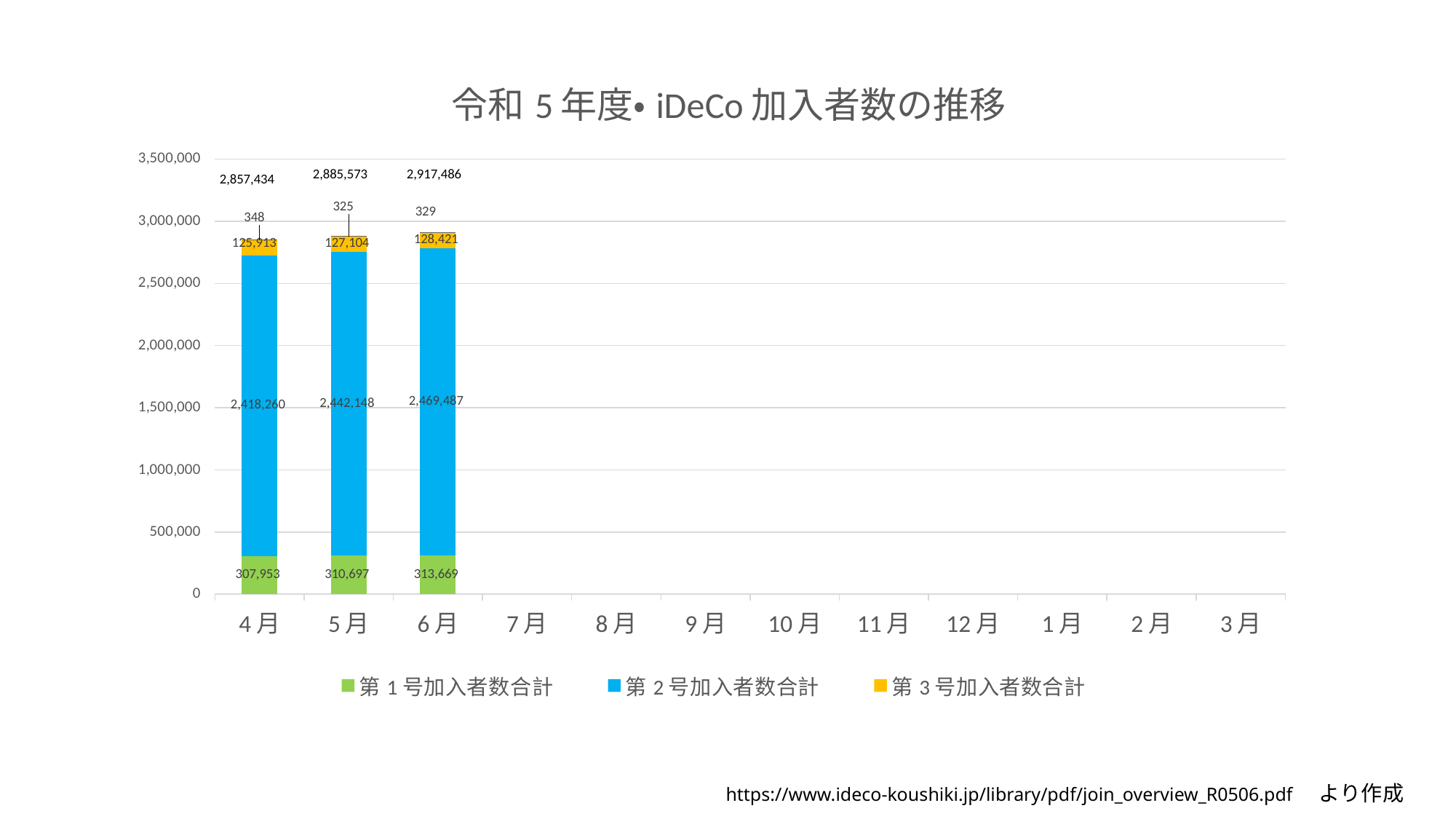
How many series does the legend list? 3 Among the months with data, which month has the lowest value for 第１号加入者数合計? 4月 How many month categories are shown on the x axis? 12 What is the value of 第２号加入者数合計 for 4月? 2,418,260 What is the value of 第３号加入者数合計 for 5月? 127,104 What is the difference between the 第１号加入者数合計 values for 6月 and 5月? 2,972 What is the difference between the 第２号加入者数合計 values for 6月 and 4月? 51,227 Do the 第２号加入者数合計 values rise or fall from 4月 to 6月? Rise Among the months with data, which month has the highest value for 第２号加入者数合計? 6月 What is the value of 第１号加入者数合計 for 6月? 313,669 Which is larger, the 第３号加入者数合計 value for 4月 or for 6月? 6月 What kind of chart is shown on the slide? Stacked bar chart